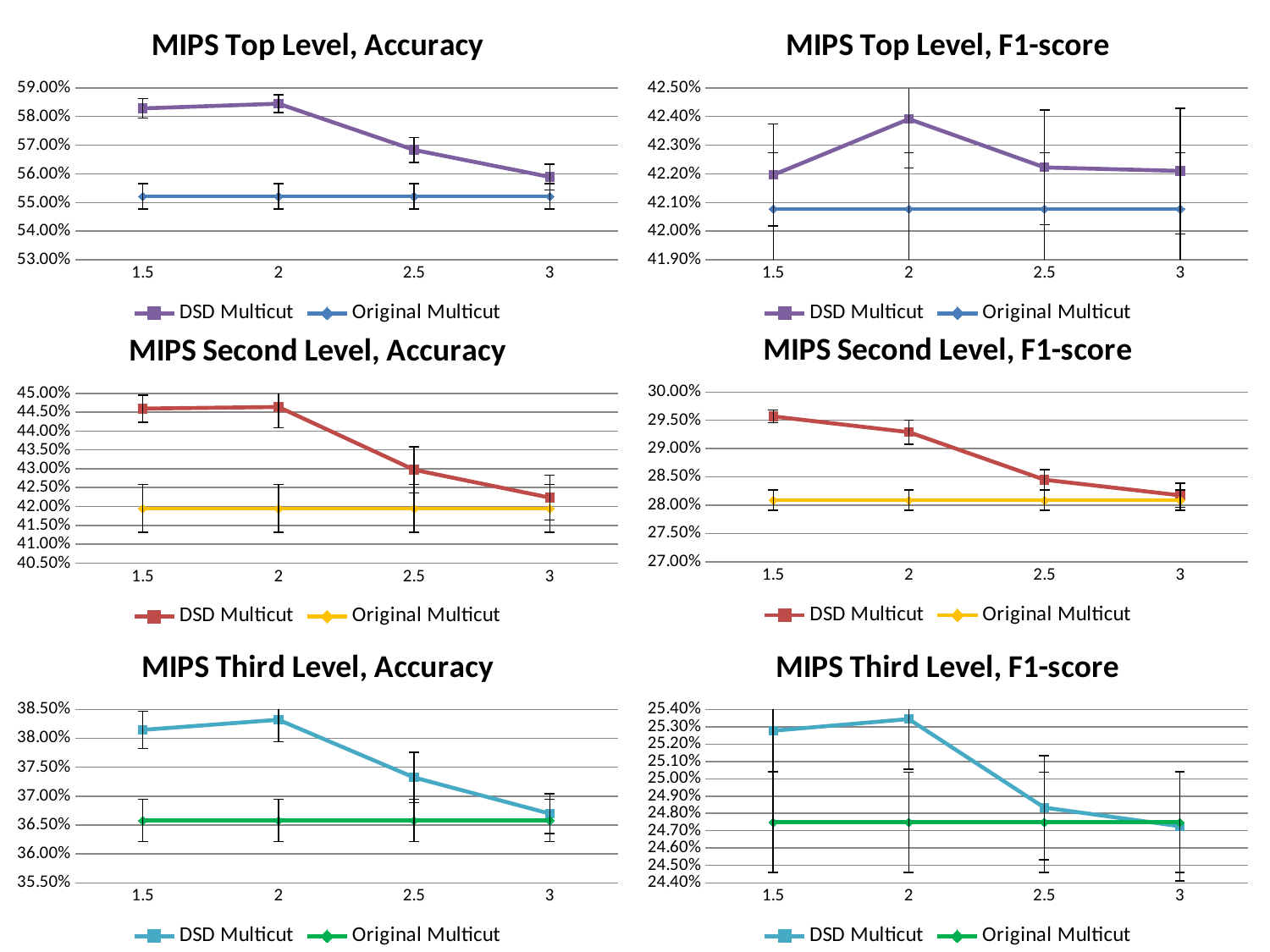
In "MIPS Second Level, Accuracy", does the Original Multicut line rise, fall, or stay flat across the x axis? stay flat In "MIPS Third Level, F1-score", is the Original Multicut value at 1.5 greater or less than 25.00%? less How many series does the legend of "MIPS Top Level, F1-score" list? 2 In "MIPS Second Level, Accuracy", does the DSD Multicut line rise or fall from 2 to 3? fall In "MIPS Second Level, F1-score", is the DSD Multicut value at 1.5 greater or less than 29.00%? greater What is the title of the chart in the bottom-right position of the slide? MIPS Third Level, F1-score What kind of chart is "MIPS Top Level, Accuracy"? Line chart In "MIPS Third Level, Accuracy", at which x value is DSD Multicut lowest? 3 In "MIPS Top Level, Accuracy", which series has the larger value at 2, DSD Multicut or Original Multicut? DSD Multicut How many x-axis points are plotted in "MIPS Second Level, Accuracy"? 4 In "MIPS Top Level, F1-score", at which x value does DSD Multicut reach its highest point? 2 In "MIPS Top Level, Accuracy", is the DSD Multicut value at 3 greater or less than 57.00%? less